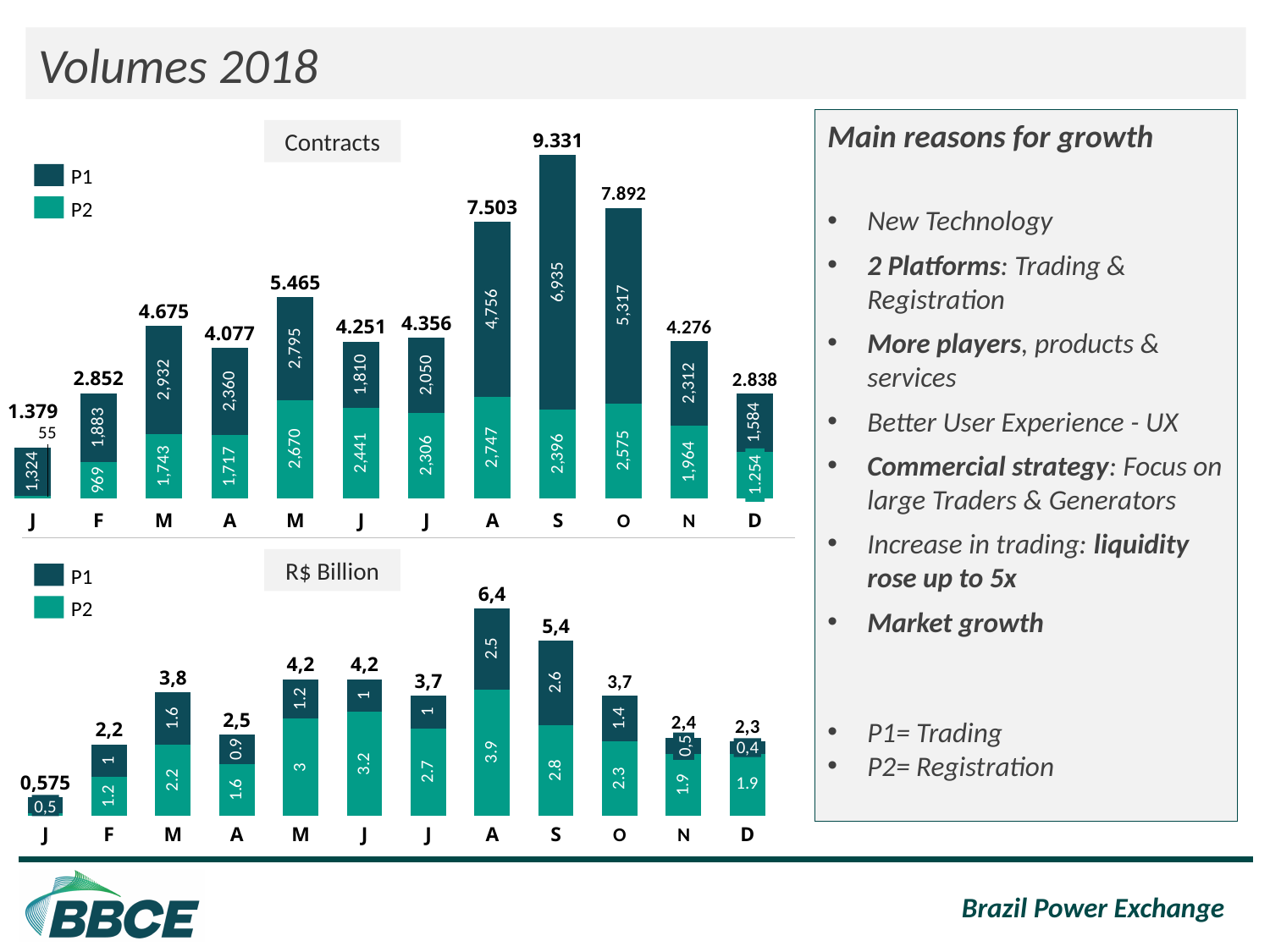
In the Contracts chart, which month bar has the lowest total? J (the first bar) In the R$ Billion chart, what is the total printed above the A bar (eighth bar)? 6,4 In the R$ Billion chart, which month bar has the highest total? A (the eighth bar) In the Contracts chart, what is the total printed above the S bar? 9.331 In the Contracts chart, what is the difference between the P1 values of the S bar and the O bar? 1,618 In the Contracts chart, which month bar has the highest total? S What type of chart is the R$ Billion chart? Stacked bar chart In the Contracts chart, what is the P2 value for the F bar? 969 In the R$ Billion chart, what is the P2 value for the S bar? 2.8 How many series does the legend of the Contracts chart list? 2 In the Contracts chart, what is the P1 value for the O bar? 5,317 In the R$ Billion chart, is the total for the S bar larger or smaller than the total for the O bar? larger